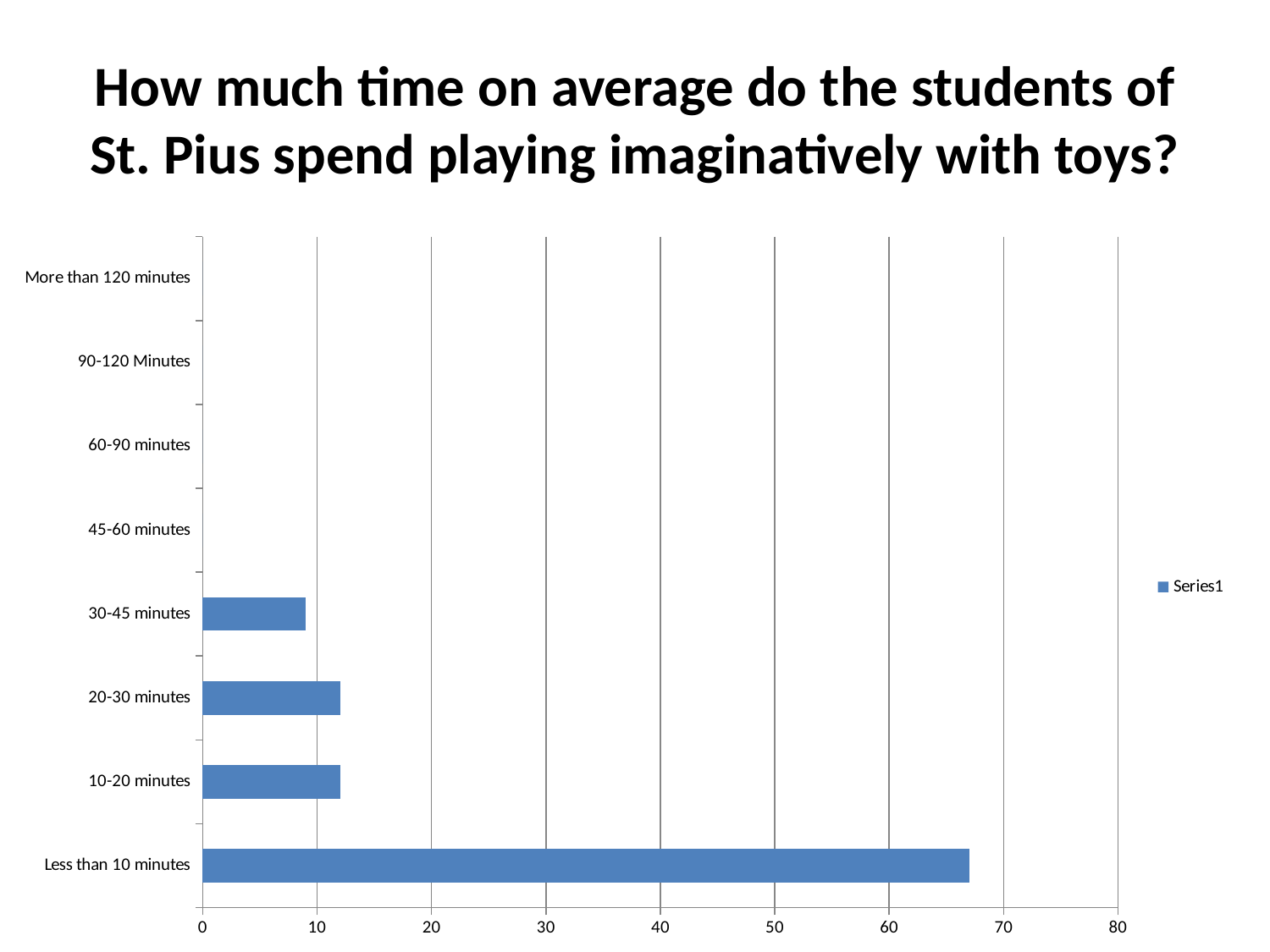
Which category has the highest value? Less than 10 minutes What is the name of the series shown in the legend? Series1 Is the value for 10-20 minutes greater or less than 20? less Is the value for Less than 10 minutes greater or less than 70? less Which is larger, the value for Less than 10 minutes or the value for 20-30 minutes? Less than 10 minutes Is the value for Less than 10 minutes greater or less than 60? greater What is the highest value shown on the horizontal axis? 80 What kind of chart is shown on the slide? bar chart How many categories are shown on the chart? 8 Which is larger, the value for 20-30 minutes or the value for 30-45 minutes? 20-30 minutes How many series does the legend list? 1